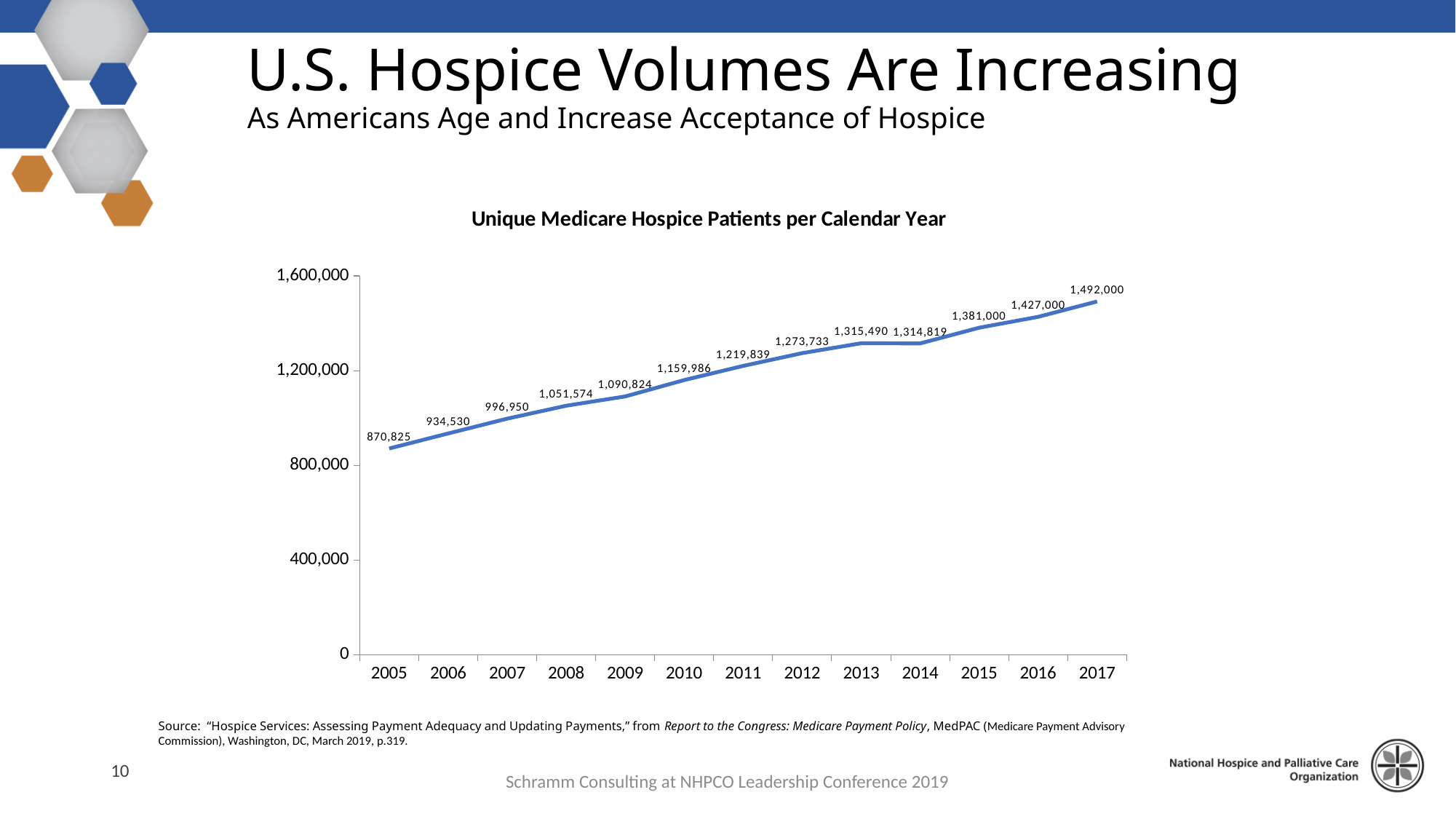
What kind of chart is shown on the slide? Line chart Which year has the highest number of unique Medicare hospice patients? 2017 How many unique Medicare hospice patients were there in 2005? 870,825 What is the value shown for 2017? 1,492,000 How many years are plotted on the x axis? 13 Is the value for 2008 greater or less than 1,200,000? less Which year has a larger value, 2009 or 2012? 2012 What is the difference between the 2016 value and the 2015 value? 46,000 What is the difference between the 2017 value and the 2005 value? 621,175 What is the title of the chart? Unique Medicare Hospice Patients per Calendar Year Which year has the lowest number of unique Medicare hospice patients? 2005 What is the value shown for 2010? 1,159,986